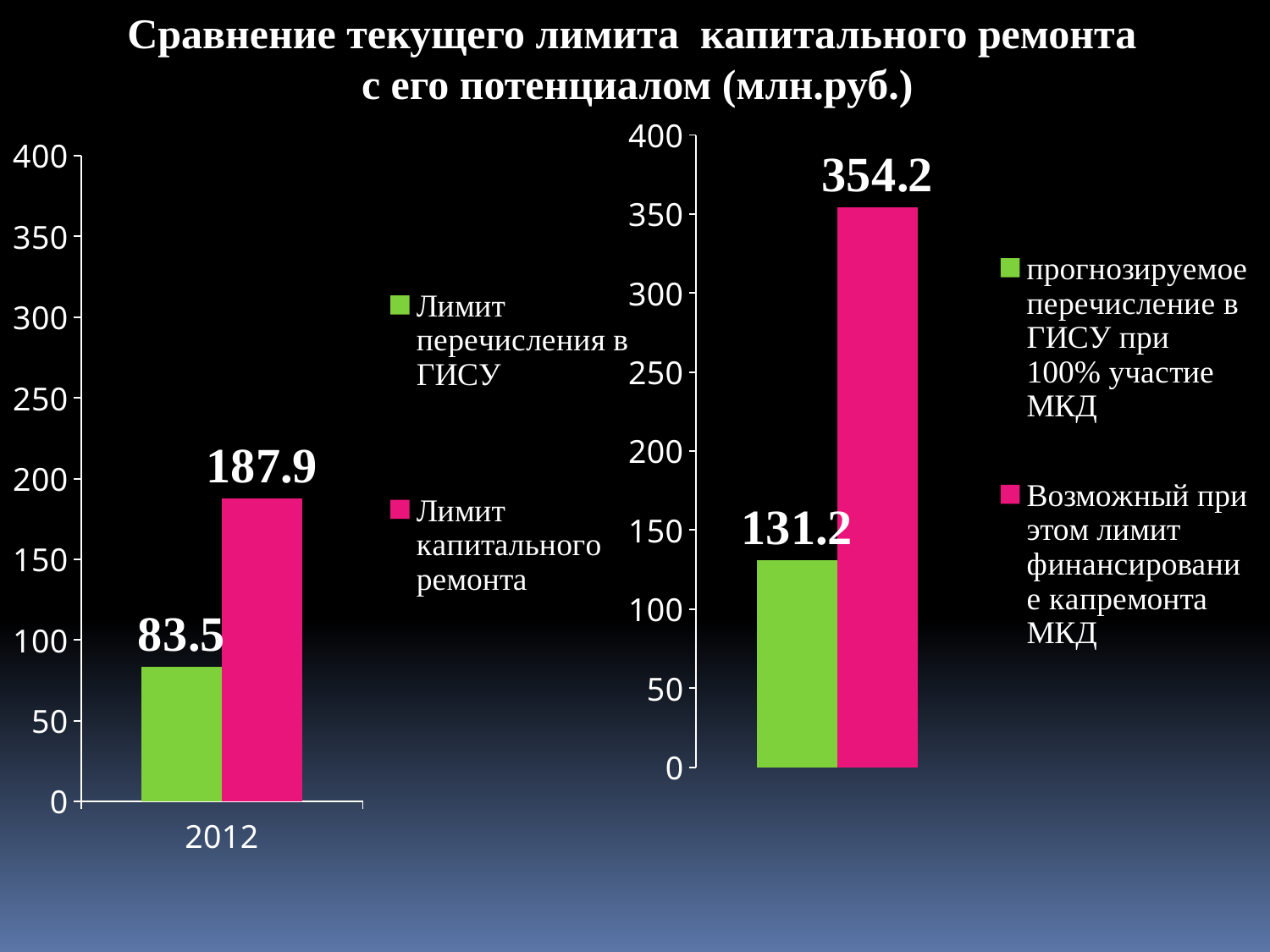
What category label appears on the x axis of the left chart? 2012 On the right chart, what is the value of 'Возможный при этом лимит финансирование капремонта МКД'? 354.2 On the left chart, what is the difference between 'Лимит капитального ремонта' and 'Лимит перечисления в ГИСУ'? 104.4 On the left chart, which series has the lower value? Лимит перечисления в ГИСУ On the right chart, what is the difference between the two plotted values? 223.0 On the right chart, what is the value of 'прогнозируемое перечисление в ГИСУ при 100% участие МКД'? 131.2 What kind of chart is the left chart? bar chart How many series does the legend of the right chart list? 2 On the left chart, is the value for 'Лимит капитального ремонта' greater or less than 150? greater On the right chart, which series has the higher value? Возможный при этом лимит финансирование капремонта МКД On the left chart, what is the value of 'Лимит перечисления в ГИСУ' for 2012? 83.5 On the left chart, what is the value of 'Лимит капитального ремонта' for 2012? 187.9